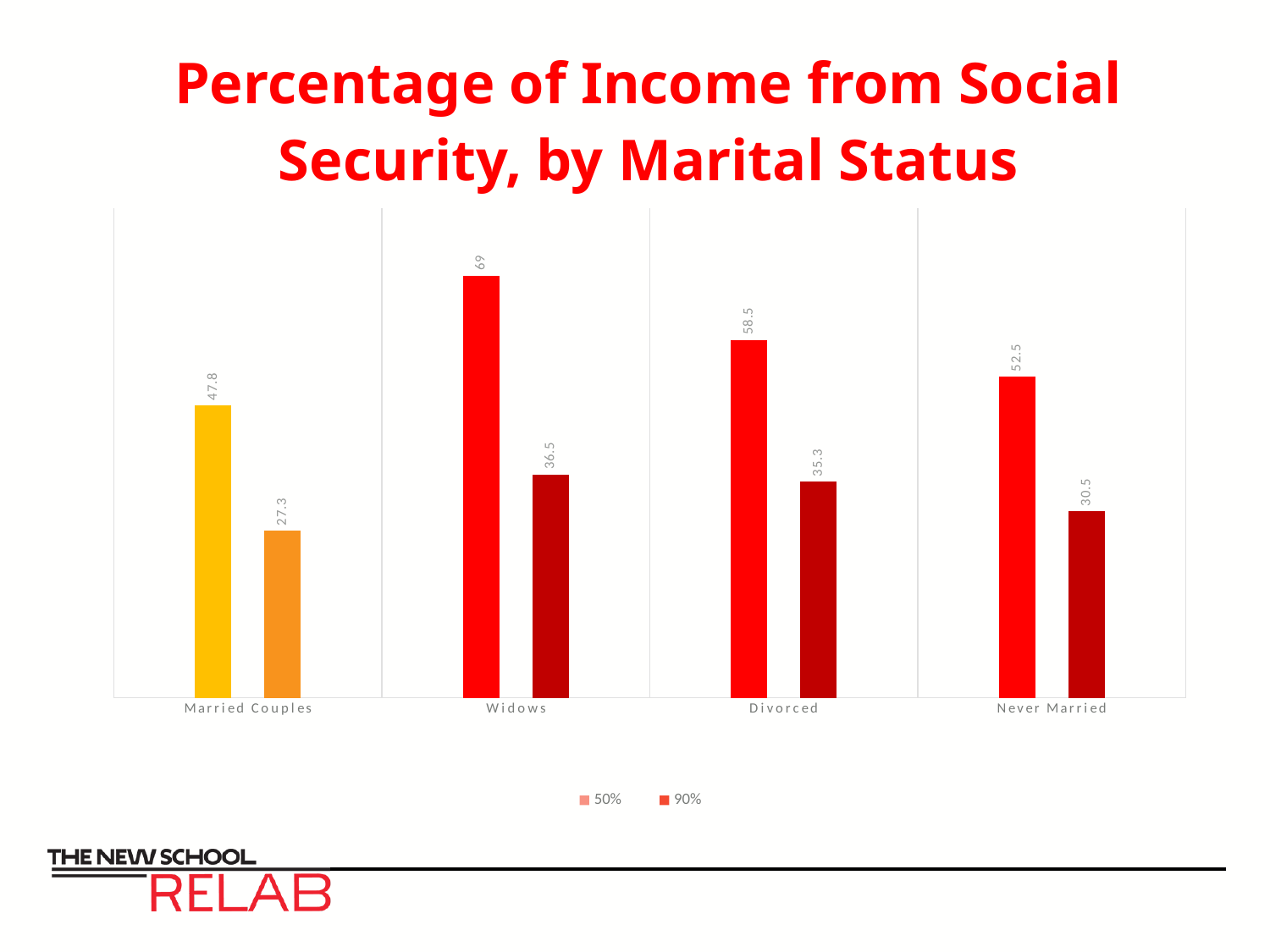
How many series does the legend list? 2 Which is larger, the 90% value for Widows or the 90% value for Divorced? Widows What is the difference between the 50% and 90% values for Widows? 32.5 What is the value for the 50% series for Never Married? 52.5 What is the value for the 90% series for Divorced? 35.3 What is the value for the 50% series for Widows? 69 What kind of chart is shown on the slide? Bar chart What is the value for the 90% series for Married Couples? 27.3 How many marital status categories are shown on the x axis? 4 Which marital status has the lowest value in the 90% series? Married Couples Which marital status has the highest value in the 50% series? Widows What is the difference between the 50% values for Divorced and Never Married? 6